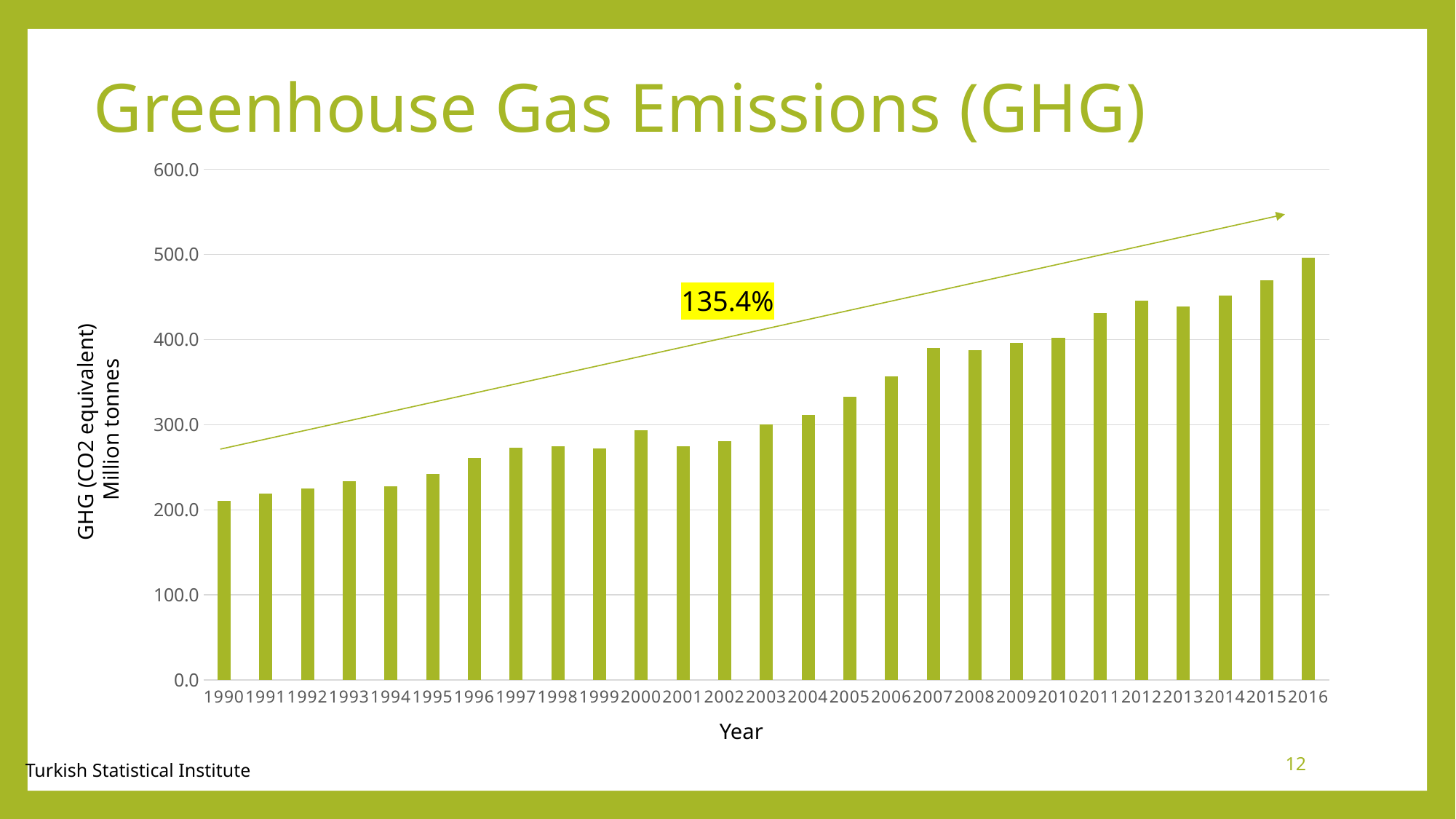
Which year has the highest greenhouse gas emissions in the chart? 2016 What kind of chart is shown on the slide? bar chart What is the label of the y axis of the chart? GHG (CO2 equivalent) Million tonnes What percentage is shown in the highlighted annotation on the chart? 135.4% Do greenhouse gas emissions generally rise or fall from 1990 to 2016? rise Which year has higher emissions, 2000 or 2001? 2000 How many years are plotted on the x axis of the chart? 27 Is the value for 2005 greater or less than 300? greater Is the value for 2011 greater or less than 400? greater Is the value for 1990 greater or less than 300? less Which year has the lowest greenhouse gas emissions in the chart? 1990